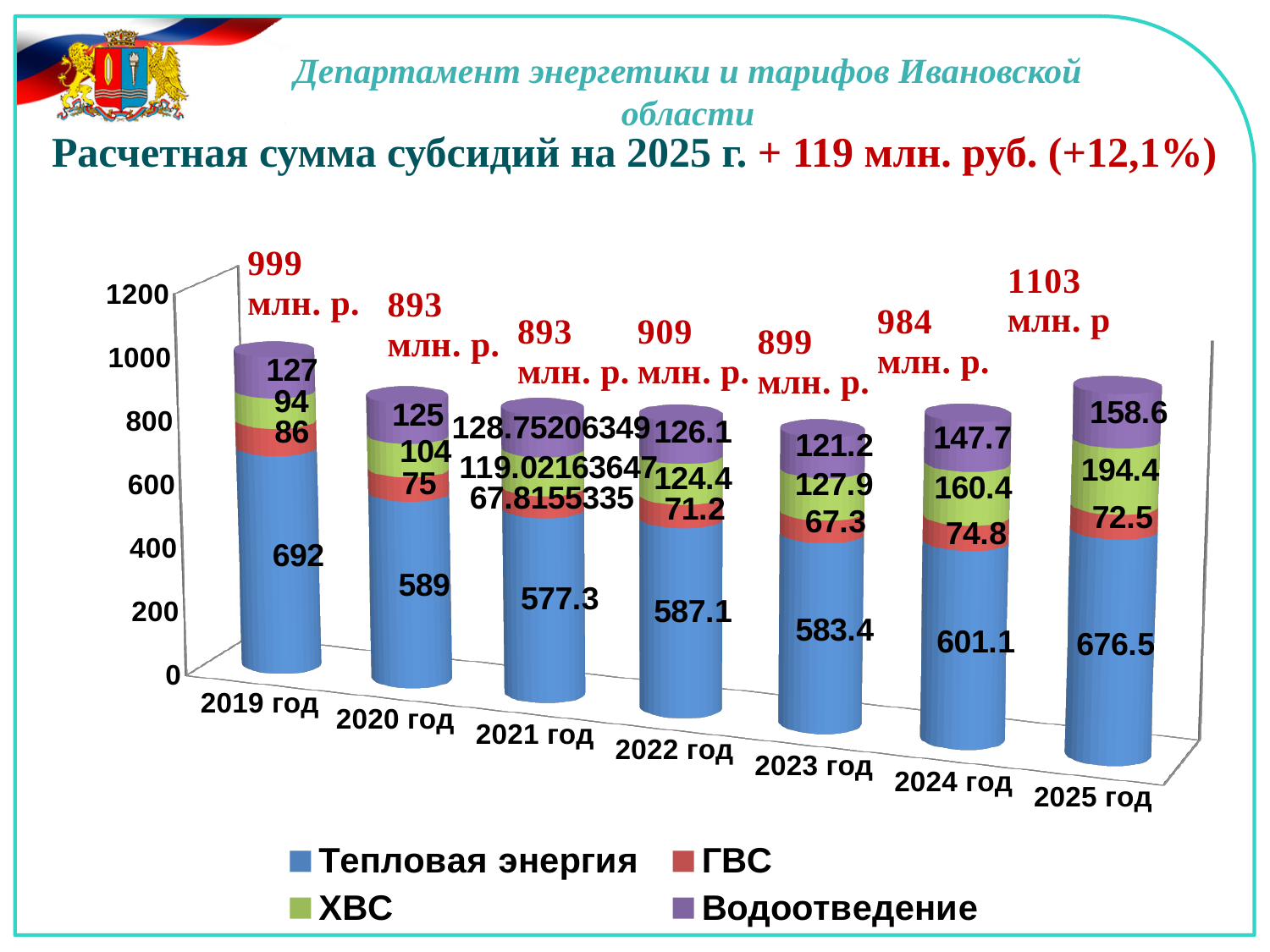
What is the difference between the Тепловая энергия values for 2019 год and 2025 год? 15.5 What total is printed above the bar for 2025 год? 1103 млн. р How many series does the legend list? 4 How many years are shown on the x axis? 7 In which year is the Тепловая энергия value the lowest? 2021 год What is the value for ГВС in 2022 год? 71.2 What is the value for Тепловая энергия in 2019 год? 692 What kind of chart is shown on the slide? Stacked bar chart What is the value for ХВС in 2024 год? 160.4 What is the value for Водоотведение in 2025 год? 158.6 Which is larger, the ГВС value for 2019 год or for 2025 год? 2019 год In which year is the Тепловая энергия value the highest? 2019 год